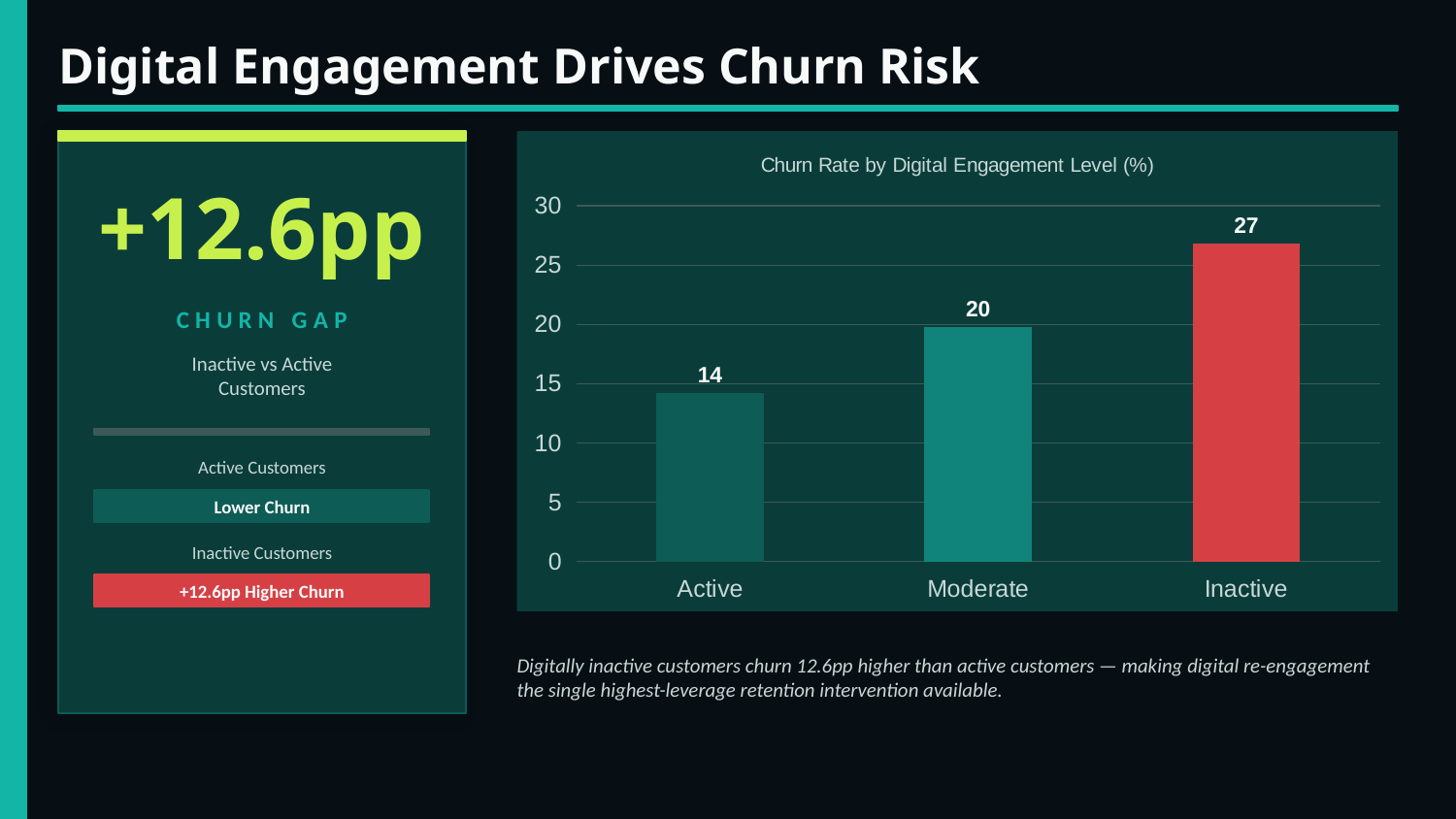
What is the difference in churn rate between Inactive and Active customers? 13 What is the difference in churn rate between Moderate and Active customers? 6 What kind of chart is shown on the slide? Bar chart Which engagement level has the highest churn rate? Inactive Do churn rates rise or fall from Active to Inactive along the x axis? Rise Which engagement level has the lowest churn rate? Active What is the churn rate for Moderate engagement customers? 20 Is the churn rate for Inactive customers greater or less than 25? greater How many engagement levels are shown on the chart? 3 Which has a higher churn rate, Moderate or Inactive? Inactive What is the churn rate for Inactive customers? 27 What is the churn rate for Active customers? 14